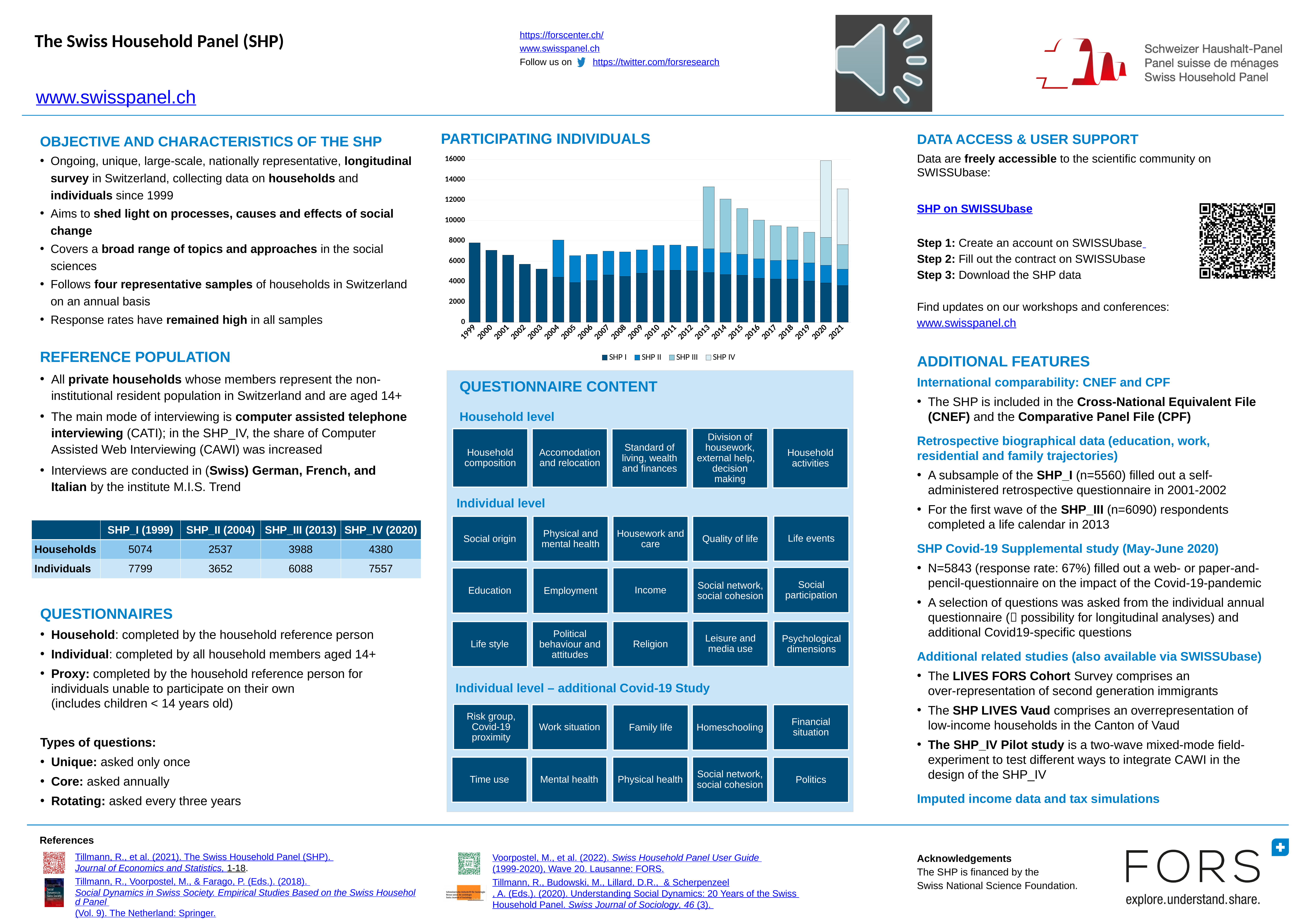
In the 'PARTICIPATING INDIVIDUALS' chart, which year has the shortest stacked bar? 2003 In the 'PARTICIPATING INDIVIDUALS' chart, which year has the tallest stacked bar? 2020 In the 'PARTICIPATING INDIVIDUALS' chart, which stacked bar is taller, 1999 or 2003? 1999 In the 'PARTICIPATING INDIVIDUALS' chart, is the total for 2003 greater or less than 6000? less Which series is listed first in the legend of the 'PARTICIPATING INDIVIDUALS' chart? SHP I In the 'PARTICIPATING INDIVIDUALS' chart, is the total for 2013 greater or less than 12000? greater How many years are shown on the x axis of the 'PARTICIPATING INDIVIDUALS' chart? 23 In the 'PARTICIPATING INDIVIDUALS' chart, in which year does the SHP IV series first appear? 2020 In the 'PARTICIPATING INDIVIDUALS' chart, which stacked bar is taller, 2020 or 2013? 2020 In the 'PARTICIPATING INDIVIDUALS' chart, is the total for 2020 greater or less than 14000? greater What kind of chart is shown under 'PARTICIPATING INDIVIDUALS'? stacked bar chart How many series does the legend of the 'PARTICIPATING INDIVIDUALS' chart list? 4